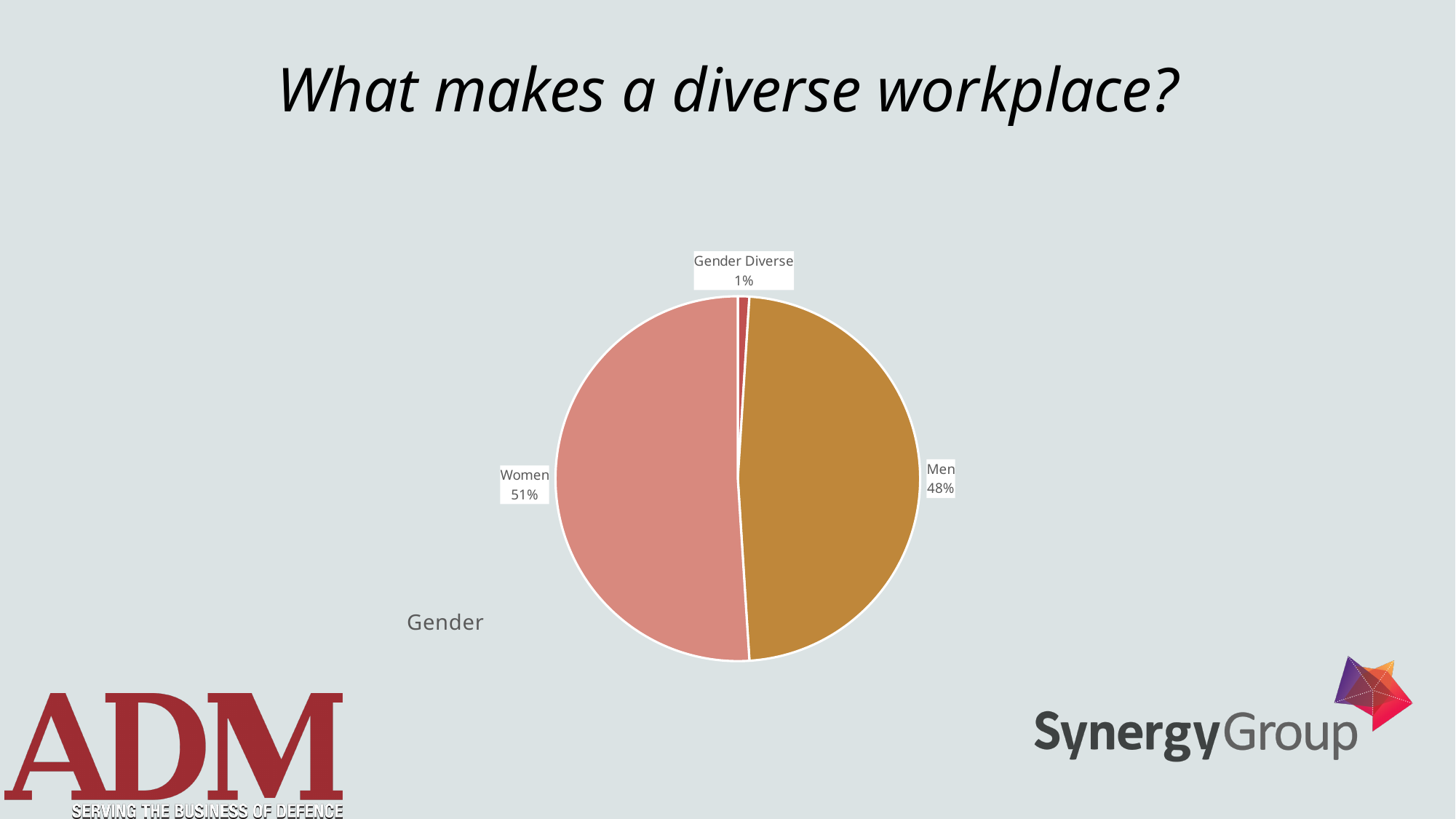
What is the label shown beneath the pie chart? Gender What is the difference in percentage points between the Men and Gender Diverse slices? 47 What share of the pie chart is Gender Diverse? 1% Which category has the smallest slice of the pie chart? Gender Diverse Which slice is larger, Men or Gender Diverse? Men What type of chart is shown on the slide? Pie chart Which slice is larger, Women or Men? Women Which category has the largest slice of the pie chart? Women How many categories are shown in the pie chart? 3 What share of the pie chart is Men? 48% What share of the pie chart is Women? 51% What is the difference in percentage points between the Women and Men slices? 3